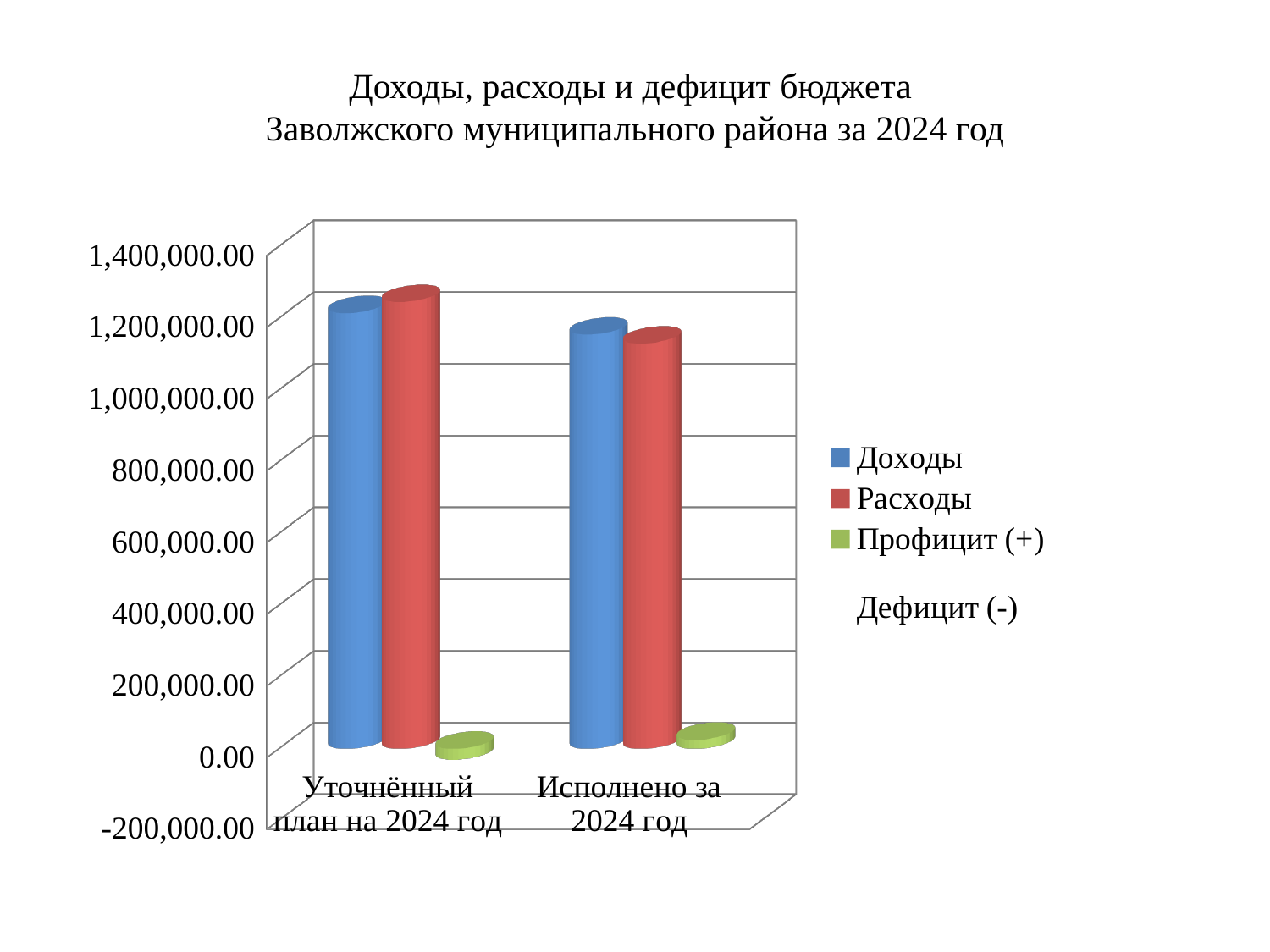
Is the value of Расходы for Исполнено за 2024 год greater or less than 1,200,000.00? less Which colour represents the Расходы series in the chart? Red What kind of chart is shown on the slide? Bar chart For Уточнённый план на 2024 год, which is larger: Доходы or Расходы? Расходы For Исполнено за 2024 год, which is larger: Доходы or Расходы? Доходы How many categories are shown on the x axis of the chart? 2 What is the title of the chart? Доходы, расходы и дефицит бюджета Заволжского муниципального района за 2024 год Is the value of Расходы for Уточнённый план на 2024 год greater or less than 1,400,000.00? less Is the value of Профицит (+) Дефицит (-) for Исполнено за 2024 год greater or less than 200,000.00? less Does the Доходы series rise or fall from Уточнённый план на 2024 год to Исполнено за 2024 год? Fall How many series does the chart legend list? 3